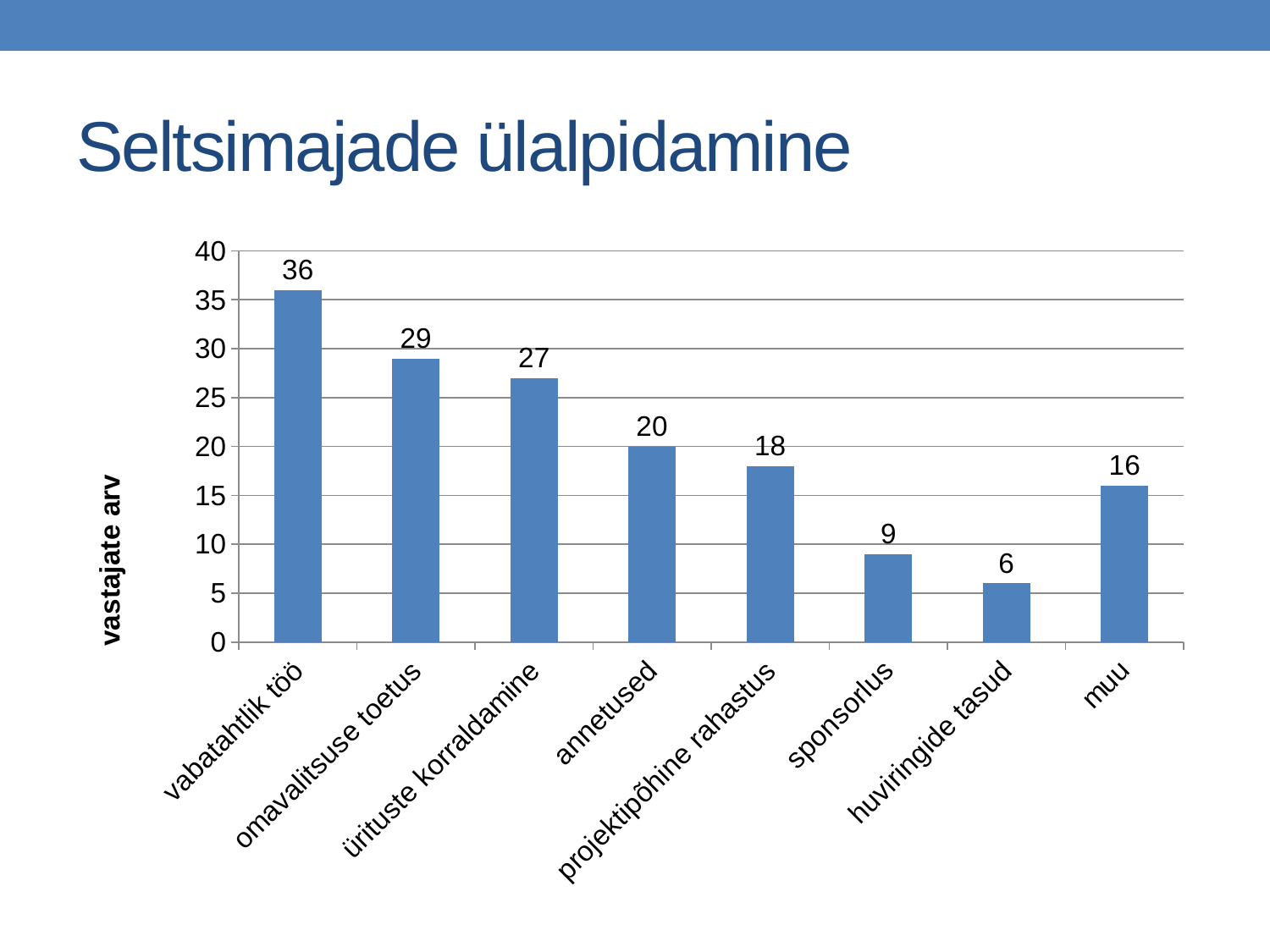
What is the value for projektipõhine rahastus? 18 What is the label of the vertical axis? vastajate arv What is the value for vabatahtlik töö? 36 Which is larger, the value for muu or the value for sponsorlus? muu Is the value for annetused greater or less than 15? greater What kind of chart is shown on the slide? bar chart Which category has the highest value? vabatahtlik töö What is the value for muu? 16 Which category has the lowest value? huviringide tasud What is the difference between the values for omavalitsuse toetus and ürituste korraldamine? 2 What is the difference between the values for annetused and sponsorlus? 11 How many categories are shown on the x axis? 8